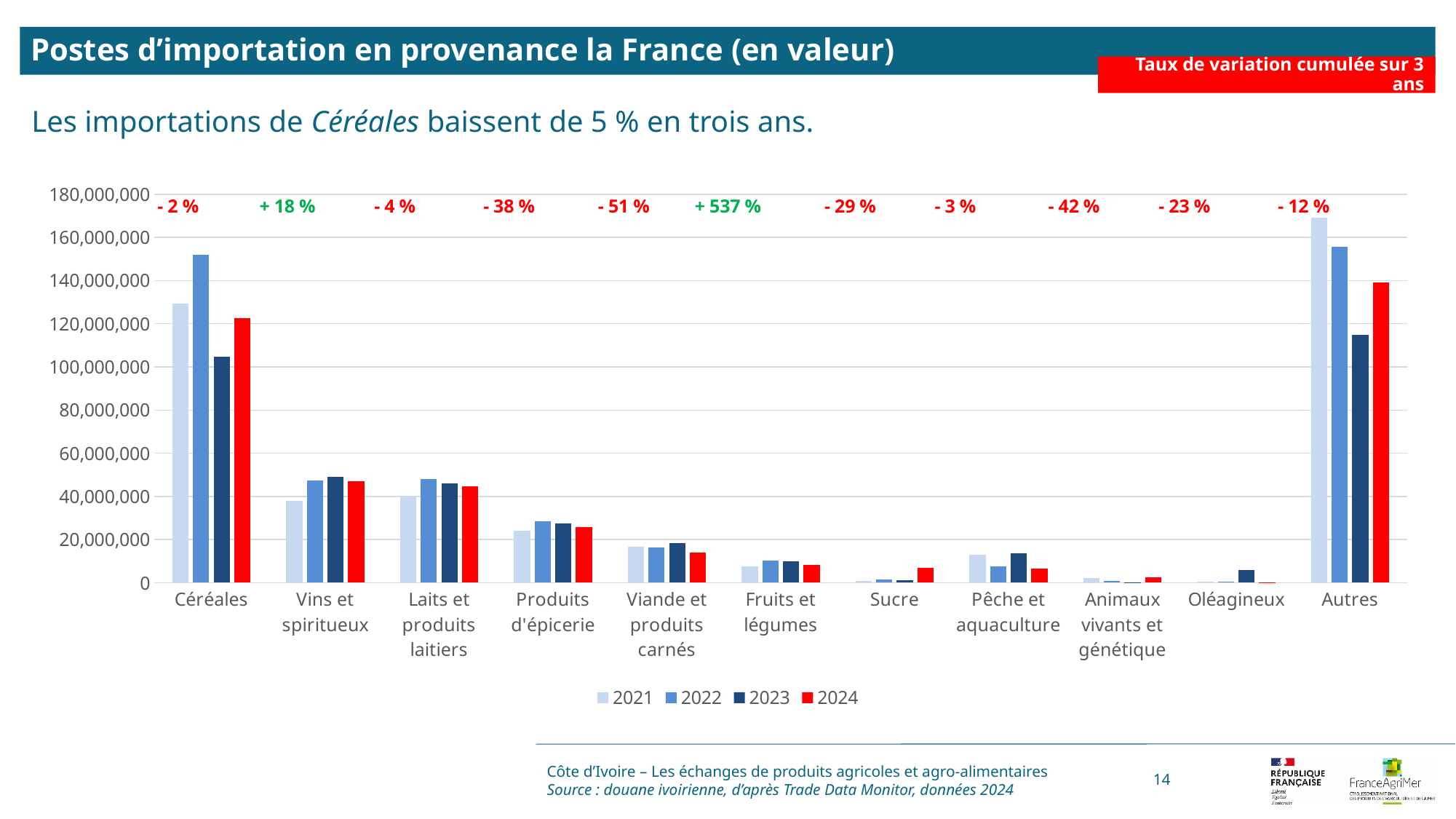
What is the cumulative variation rate over 3 years shown for Sucre? - 29 % What is the cumulative variation rate over 3 years shown for Fruits et légumes? + 537 % How many series does the legend list? 4 Is the 2023 value for Autres greater or less than 120,000,000? less Which category has the highest 2024 bar? Autres Which category has the lowest cumulative variation rate over 3 years? Viande et produits carnés What is the cumulative variation rate over 3 years shown for Vins et spiritueux? + 18 % Is the 2022 value for Céréales greater or less than 140,000,000? greater For Céréales, which is larger: the 2021 value or the 2023 value? 2021 Which colour represents the 2024 series in the legend? red How many product categories are shown on the x axis? 11 What kind of chart is shown on the slide? bar chart